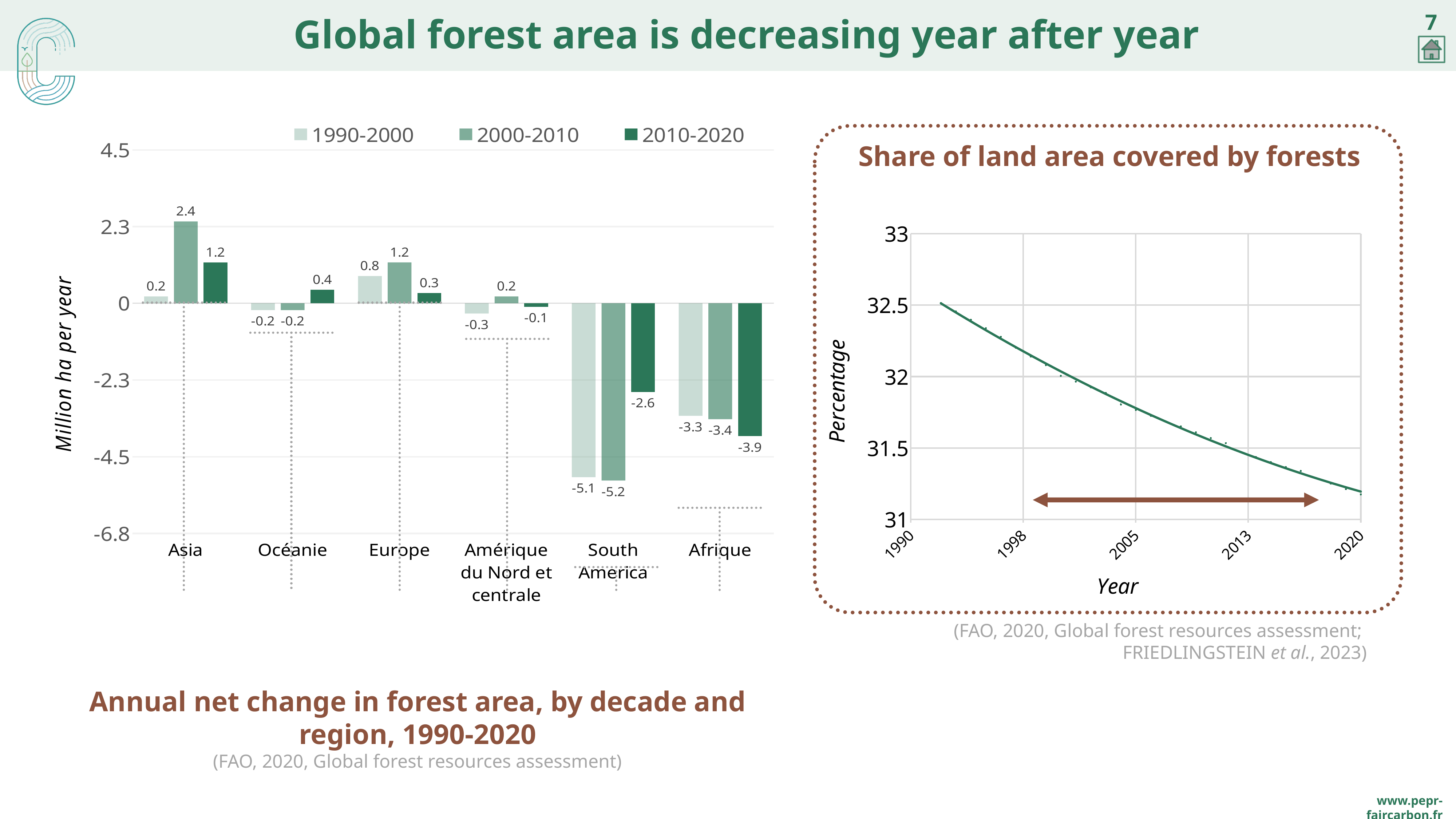
In the chart 'Annual net change in forest area, by decade and region, 1990-2020', what is the value for South America in 2010-2020? -2.6 In the chart 'Annual net change in forest area, by decade and region, 1990-2020', which is larger for Europe: the 1990-2000 value or the 2000-2010 value? 2000-2010 In the chart 'Annual net change in forest area, by decade and region, 1990-2020', which region has the highest value in the 2010-2020 series? Asia In the chart 'Share of land area covered by forests', is the value for 2020 greater or less than 31.5? less How many series does the legend of the chart 'Annual net change in forest area, by decade and region, 1990-2020' list? 3 How many regions are shown on the x axis of the chart 'Annual net change in forest area, by decade and region, 1990-2020'? 6 In the chart 'Share of land area covered by forests', does the percentage rise or fall from 1990 to 2020? Fall In the chart 'Annual net change in forest area, by decade and region, 1990-2020', which region has the lowest value in the 2000-2010 series? South America In the chart 'Annual net change in forest area, by decade and region, 1990-2020', what is the difference between the Asia values for 2000-2010 and 2010-2020? 1.2 What kind of chart is 'Share of land area covered by forests'? Line chart In the chart 'Annual net change in forest area, by decade and region, 1990-2020', what is the value for Afrique in 1990-2000? -3.3 In the chart 'Annual net change in forest area, by decade and region, 1990-2020', what is the value for Asia in 2000-2010? 2.4